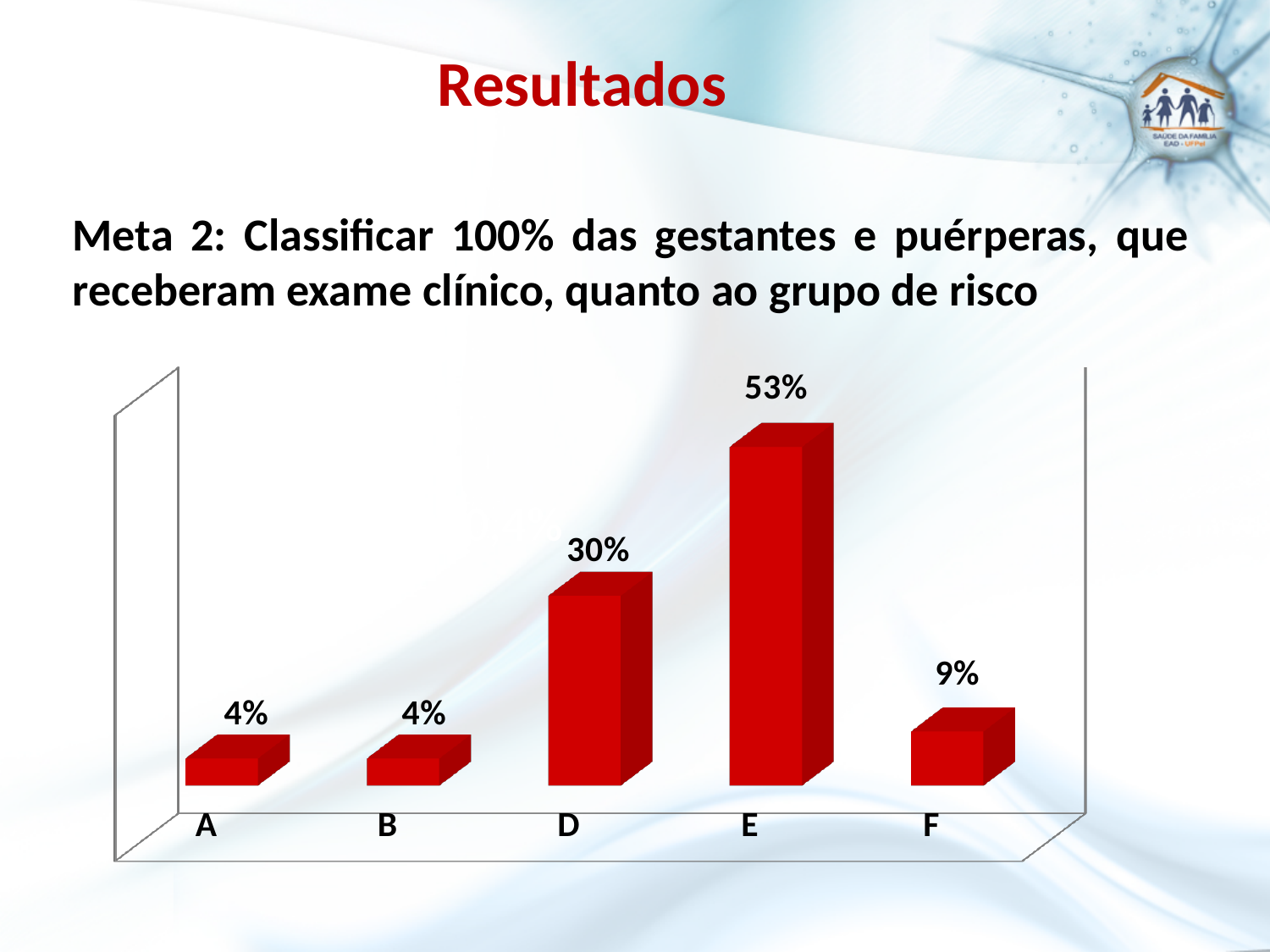
Which two categories share the same value? A and B Which category has the highest value? E What is the value for category D? 30% How many categories are shown on the x axis? 5 What is the value for category A? 4% What is the difference between the values for F and B? 5% What is the difference between the values for E and D? 23% What is the value for category F? 9% What is the value for category E? 53% Which is larger, the value for D or the value for F? D What colour are the bars in the chart? Red What kind of chart is shown on the slide? Bar chart